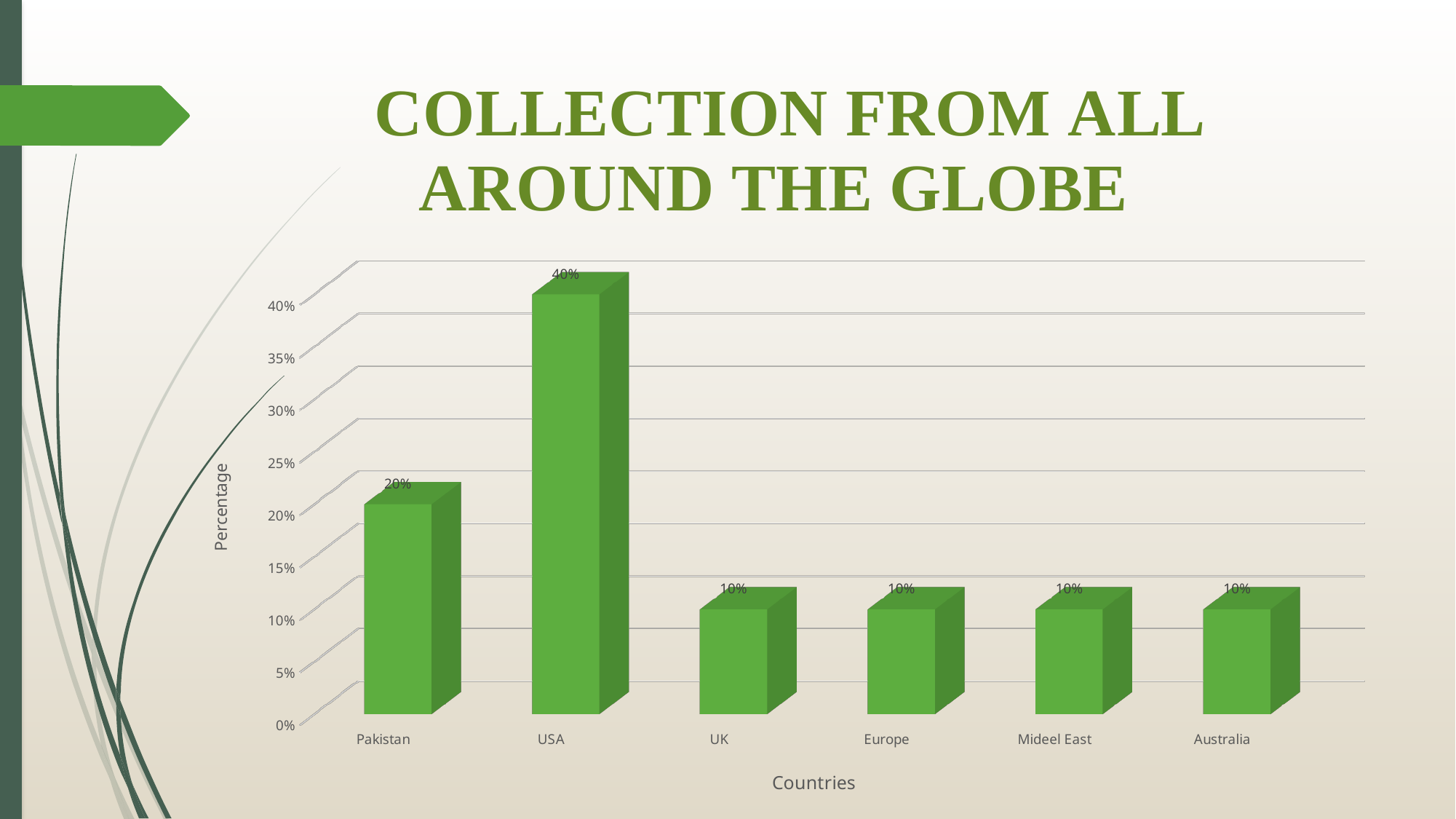
How many countries are shown on the x axis? 6 Is the value for USA greater or less than 35%? greater What is the difference between the values for Pakistan and UK? 10% What kind of chart is shown on the slide? bar chart What is the label of the vertical axis? Percentage Which country has the highest value? USA What is the title of the slide? COLLECTION FROM ALL AROUND THE GLOBE What is the value for Pakistan? 20% What is the value for USA? 40% What is the difference between the values for USA and Pakistan? 20% What is the value for Europe? 10% Which is larger, the value for Pakistan or the value for Australia? Pakistan